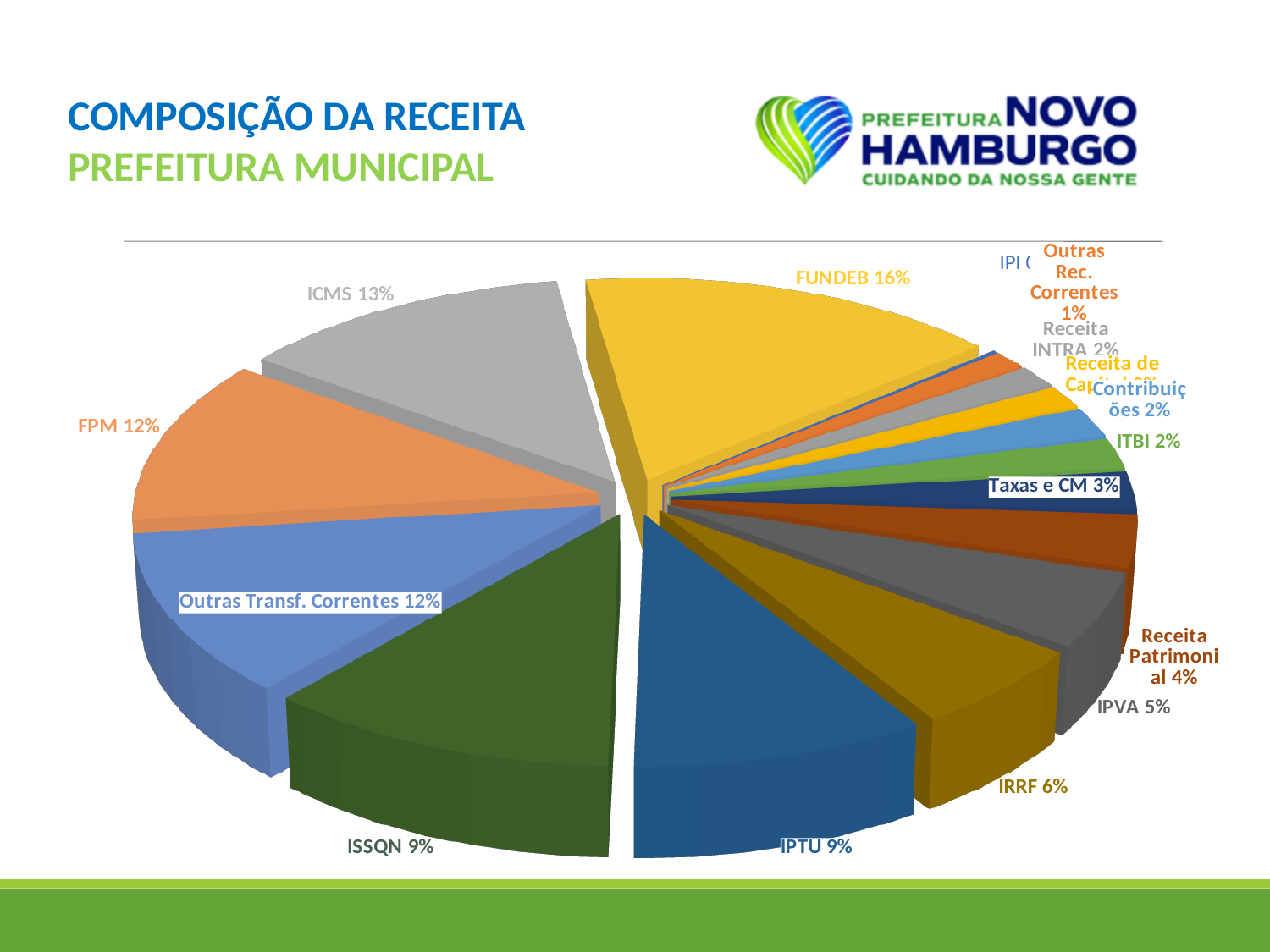
What is the share for Taxas e CM? 3% What is the title of the slide containing the chart? COMPOSIÇÃO DA RECEITA PREFEITURA MUNICIPAL What percentage is shown for ICMS? 13% What share does IRRF have in the pie chart? 6% What is the share for FPM? 12% What percentage is shown for Receita Patrimonial? 4% What percentage is labelled for Outras Transf. Correntes? 12% What share of the revenue does FUNDEB represent? 16% Which category has the largest share of the revenue? FUNDEB How many percentage points larger is FUNDEB's share than ICMS's share? 3 percentage points What type of chart is shown on the slide? Pie chart Which has a larger share, IRRF or IPVA? IRRF